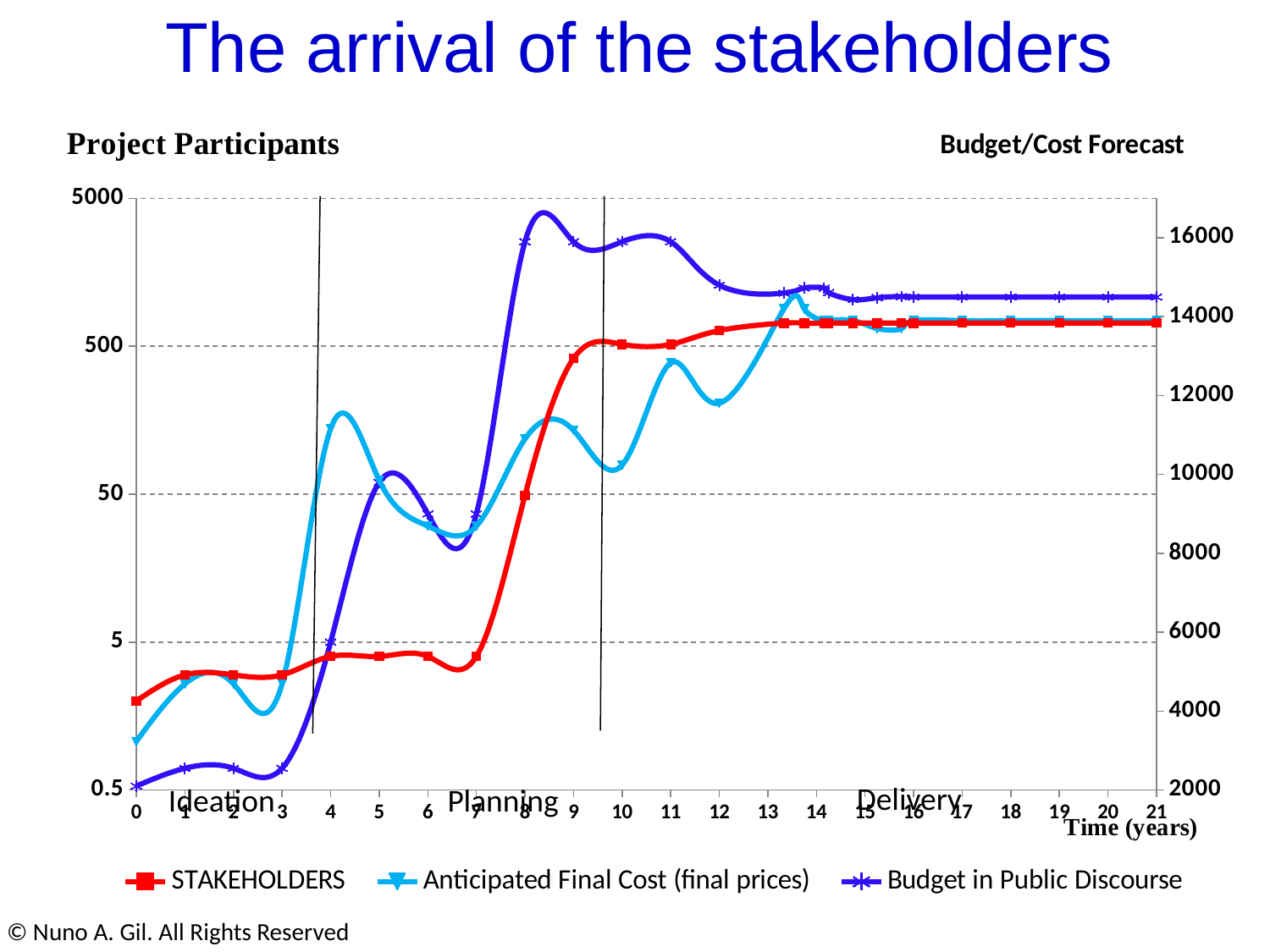
How many series does the legend list? 3 What is the title of the left-hand vertical axis? Project Participants Is the value for Budget in Public Discourse at year 8 greater or less than 14000? greater Is the value for Anticipated Final Cost (final prices) at year 3 greater or less than 6000? less What three project phases are labelled along the bottom of the chart? Ideation, Planning, Delivery How many time points (years) are labelled on the x axis? 22 Is the value for STAKEHOLDERS at year 21 greater or less than 500? greater What kind of chart is shown on the slide? line chart Does the STAKEHOLDERS series generally rise or fall from year 0 to year 21? rise At year 8, which series is higher on the right-hand axis: Budget in Public Discourse or Anticipated Final Cost (final prices)? Budget in Public Discourse